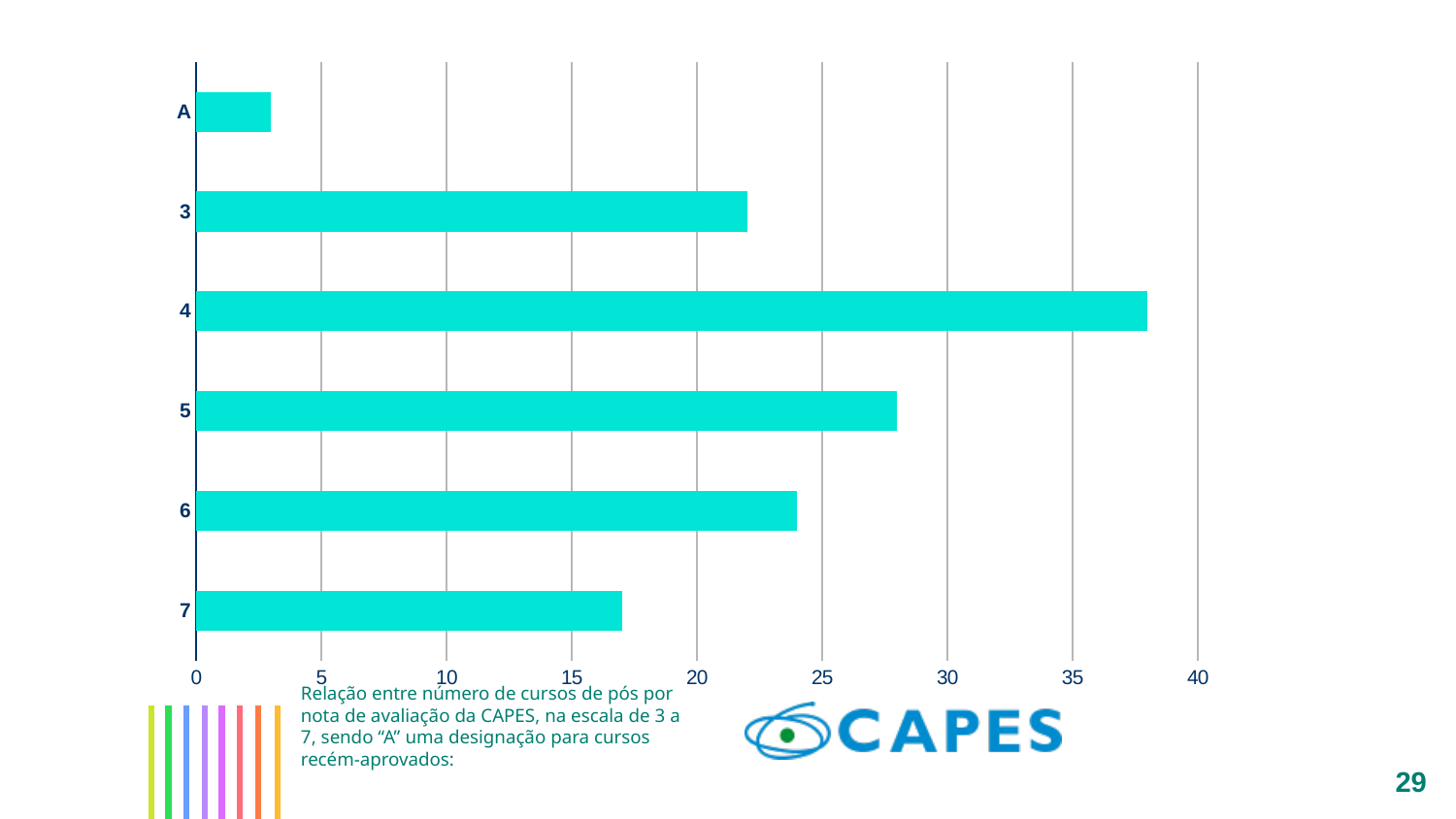
What kind of chart is shown on the slide? bar chart Is the value for category 5 greater or less than 30? less Is the value for category 4 greater or less than 35? greater Is the value for category 7 greater or less than 15? greater How many categories are plotted on the chart? 6 Which is larger, the value for category 7 or the value for category 3? 3 Which category has the lowest value? A Which category has the highest value? 4 Which is larger, the value for category 5 or the value for category 6? 5 What is the highest value shown on the horizontal axis? 40